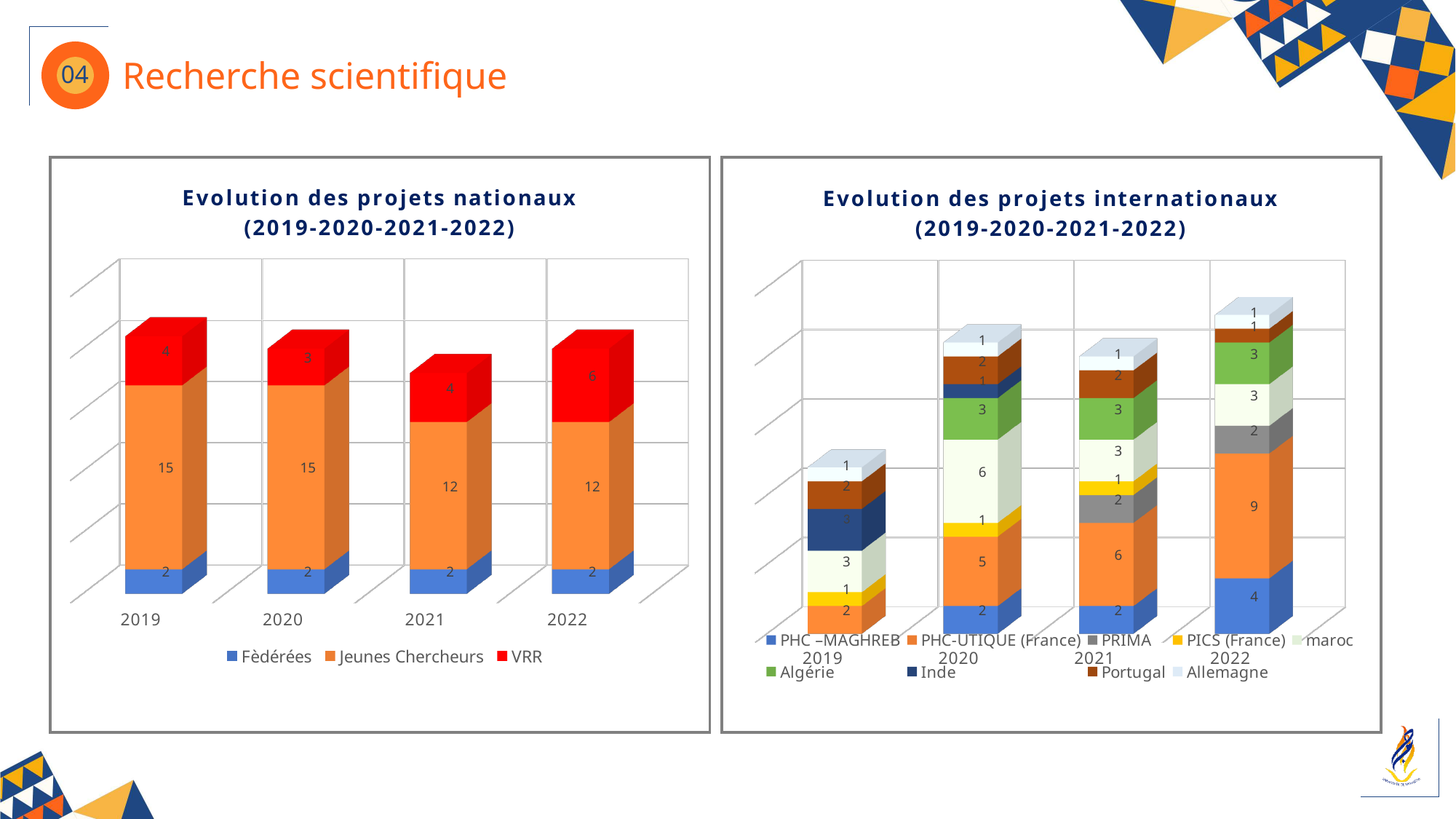
In the chart 'Evolution des projets internationaux', is the PHC –MAGHREB value larger in 2021 or in 2022? 2022 How many series does the legend of the chart 'Evolution des projets internationaux' list? 9 In the chart 'Evolution des projets nationaux', what is the difference between the Jeunes Chercheurs values for 2020 and 2021? 3 How many years are shown on the x axis of the chart 'Evolution des projets internationaux'? 4 How many series does the legend of the chart 'Evolution des projets nationaux' list? 3 In the chart 'Evolution des projets nationaux', which year has the highest VRR value? 2022 In the chart 'Evolution des projets nationaux', what is the total of the stacked bar for 2019? 21 In the chart 'Evolution des projets nationaux', what is the VRR value in 2022? 6 In the chart 'Evolution des projets nationaux', what is the value for Jeunes Chercheurs in 2019? 15 In the chart 'Evolution des projets internationaux', what is the value for PHC-UTIQUE (France) in 2022? 9 In the chart 'Evolution des projets internationaux', what is the value for maroc in 2020? 6 What kind of chart is 'Evolution des projets nationaux'? Stacked bar chart